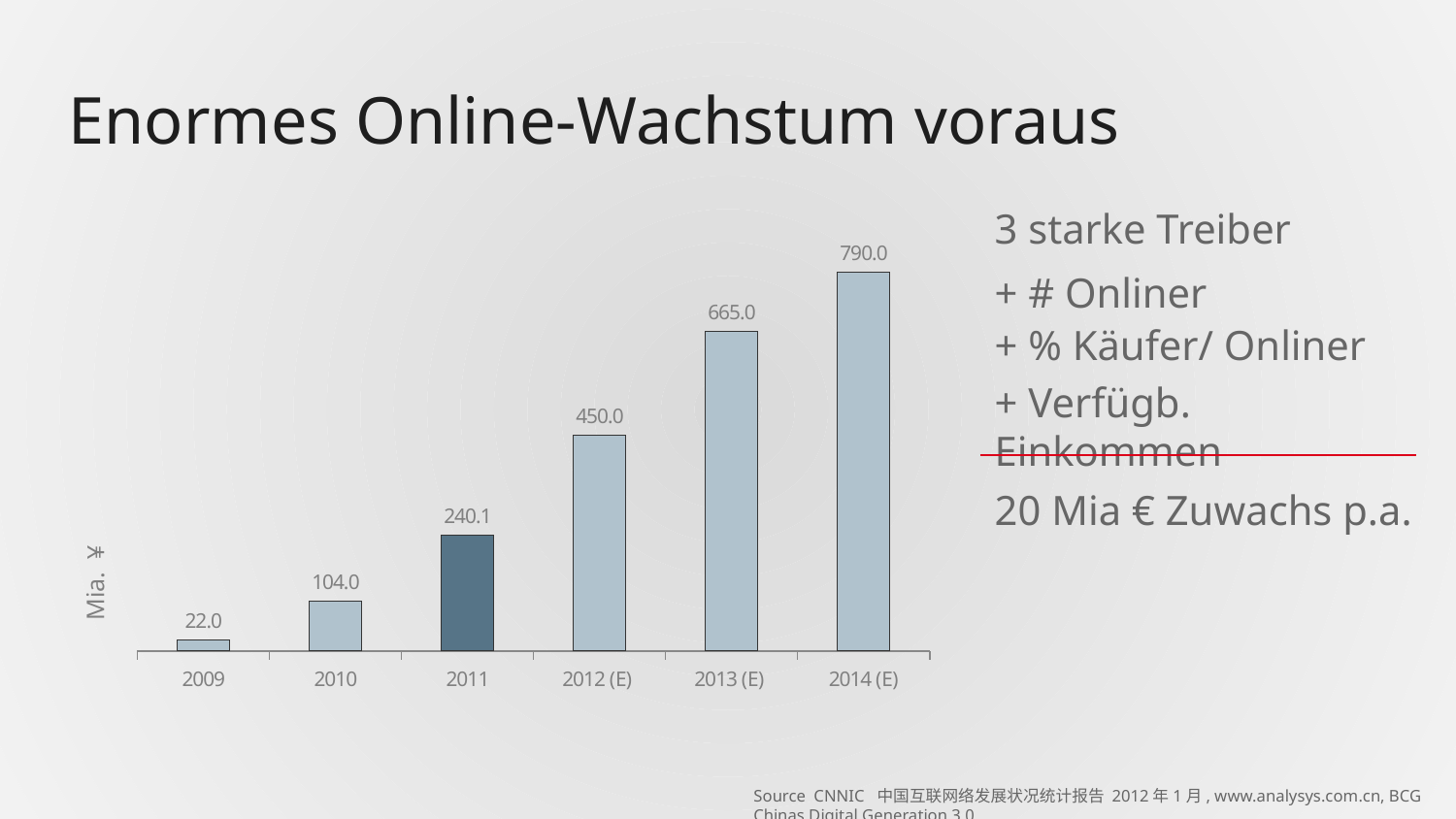
What kind of chart is shown on the slide? bar chart Which year has the lowest value? 2009 What is the label on the vertical axis of the chart? Mia. ¥ Which is larger, the value for 2010 or the value for 2011? 2011 What is the value for 2012 (E)? 450.0 Do the values rise or fall from 2009 to 2014 (E)? rise Which year has the highest value? 2014 (E) How many years are shown on the x axis? 6 What is the difference between the values for 2013 (E) and 2012 (E)? 215.0 What is the value for 2011? 240.1 What is the value for 2009? 22.0 What is the value for 2014 (E)? 790.0